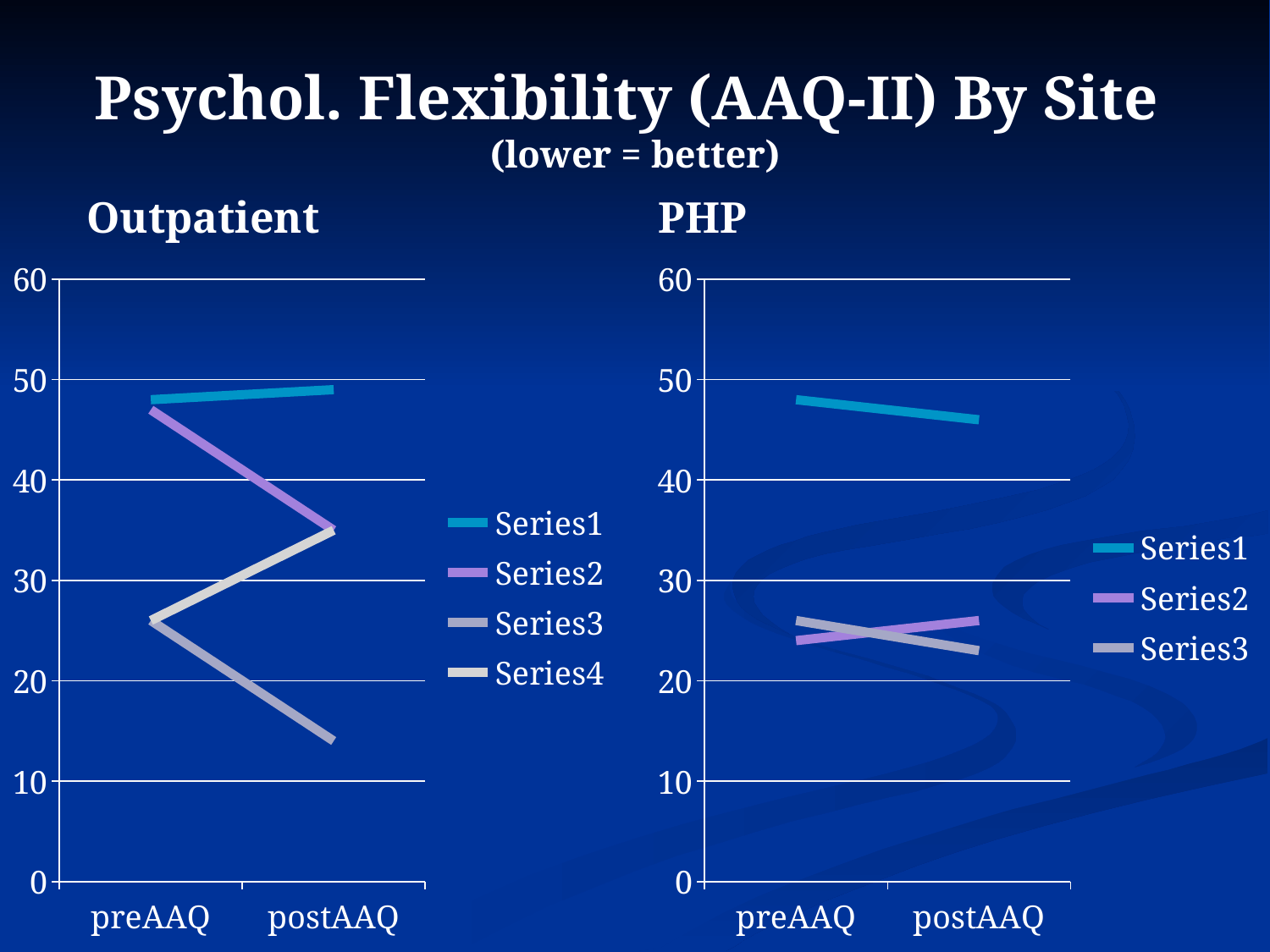
In the Outpatient chart, is the postAAQ value for Series3 greater or less than 20? less In the PHP chart, is the preAAQ value for Series1 greater or less than 40? greater In the PHP chart, which is larger at postAAQ, Series1 or Series2? Series1 In the Outpatient chart, which series has the highest value at postAAQ? Series1 How many categories are on the x axis of the PHP chart? 2 What kind of chart is the Outpatient chart? line chart In the Outpatient chart, which series has the lowest value at postAAQ? Series3 In the Outpatient chart, does Series4 rise or fall from preAAQ to postAAQ? rise How many series does the legend of the PHP chart list? 3 In the Outpatient chart, does Series3 rise or fall from preAAQ to postAAQ? fall In the PHP chart, does Series1 rise or fall from preAAQ to postAAQ? fall How many series does the legend of the Outpatient chart list? 4